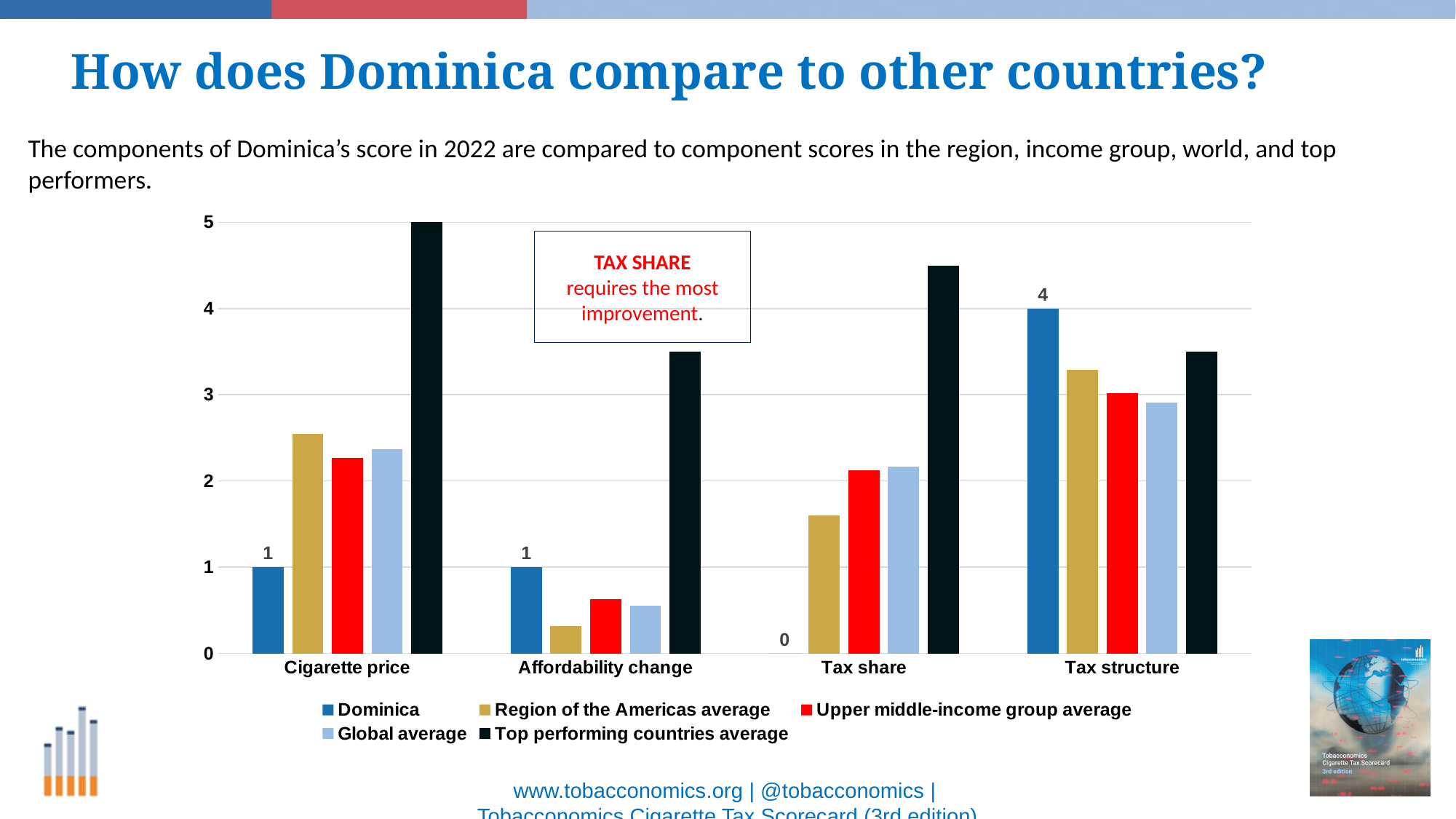
Is the value for Top performing countries average in the Affordability change category greater or less than 3? greater In which category does Dominica have its lowest score? Tax share What is the value for Dominica in the Tax share category? 0 How many series does the chart's legend list? 5 What is the difference between Dominica's Tax structure score and its Cigarette price score? 3 What kind of chart is shown on the slide? Bar chart In which category does Dominica have its highest score? Tax structure What is the value for Dominica in the Cigarette price category? 1 In the Tax share category, which is larger: Top performing countries average or Global average? Top performing countries average What is the value for Dominica in the Tax structure category? 4 How many categories are shown on the x axis of the chart? 4 What is the value for Top performing countries average in the Cigarette price category? 5